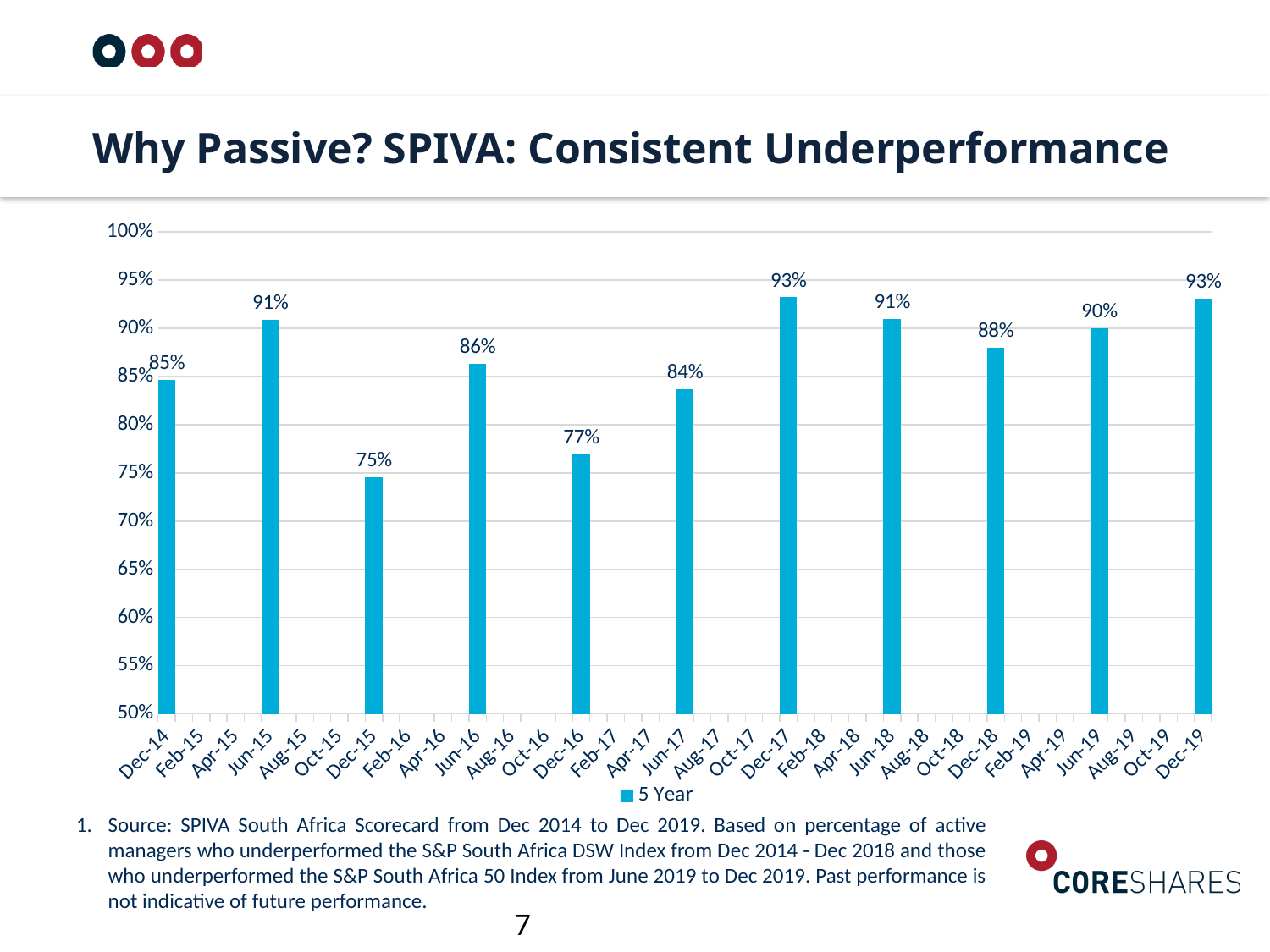
What is the value for Dec-14? 85% What is the difference between the values for Jun-15 and Jun-16? 5% What is the value for Dec-18? 88% What is the value for Dec-15? 75% Is the value for Dec-16 greater or less than 80%? less Which is larger, the value for Jun-19 or the value for Jun-17? Jun-19 What is the difference between the values for Dec-17 and Dec-16? 16% What series name does the legend show? 5 Year Which period has the lowest value? Dec-15 How many bars are plotted on the chart? 11 What kind of chart is shown on the slide? bar chart What is the value for Jun-17? 84%